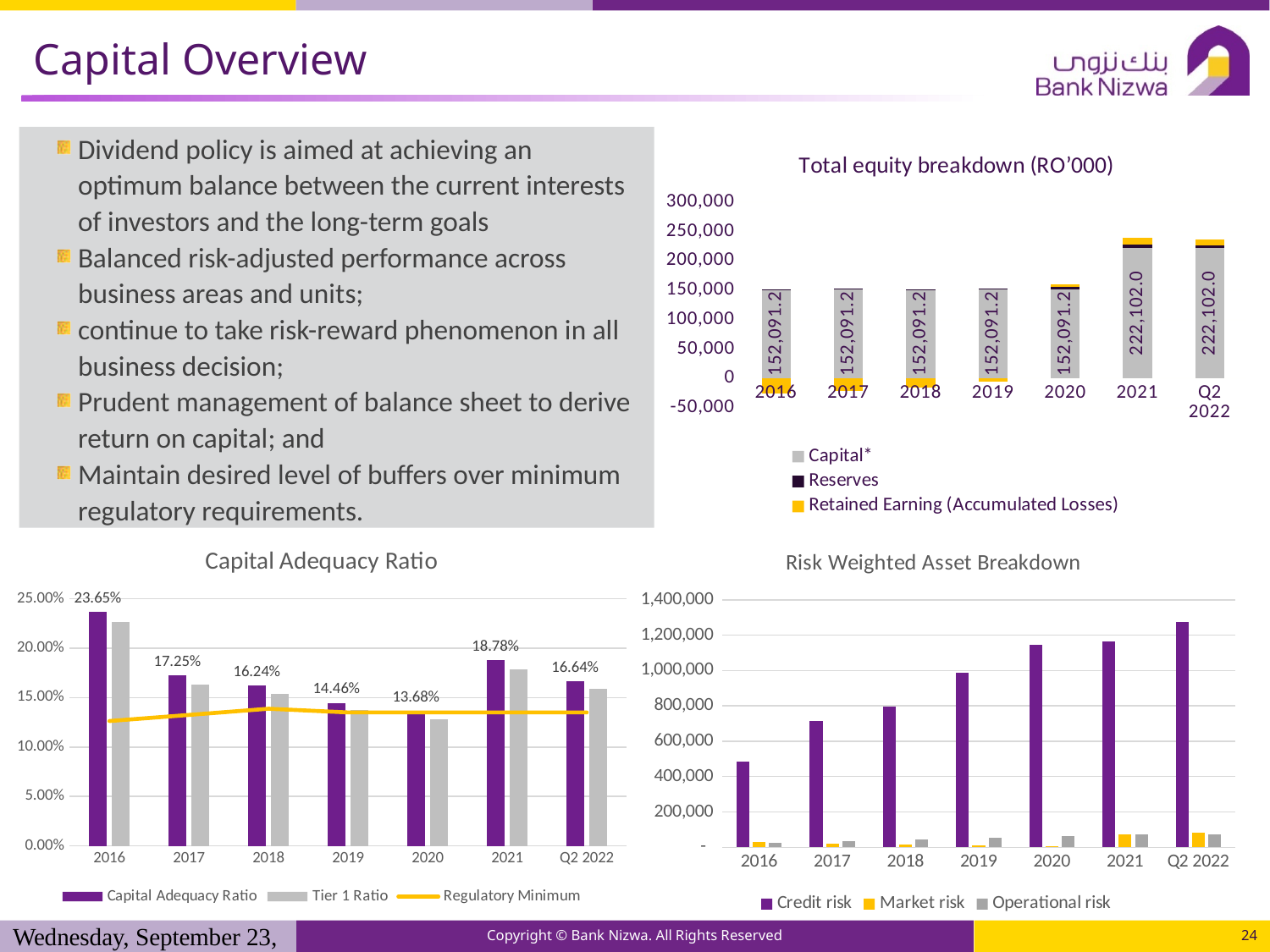
In the Total equity breakdown chart, how many periods are shown on the x axis? 7 In the Total equity breakdown chart, what is the Capital* value for 2018? 152,091.2 In the Risk Weighted Asset Breakdown chart, is the Credit risk value for 2016 greater or less than 600,000? less In the Risk Weighted Asset Breakdown chart, does Credit risk generally rise or fall from 2016 to Q2 2022? rise In the Total equity breakdown chart, what is the third legend entry? Retained Earning (Accumulated Losses) In the Capital Adequacy Ratio chart, what is the Capital Adequacy Ratio for 2016? 23.65% In the Capital Adequacy Ratio chart, what is the Capital Adequacy Ratio for Q2 2022? 16.64% In the Capital Adequacy Ratio chart, what is the difference between the Capital Adequacy Ratio in 2021 and in 2020? 5.10% In the Capital Adequacy Ratio chart, which year has the lowest labelled Capital Adequacy Ratio? 2020 In the Capital Adequacy Ratio chart, is the Capital Adequacy Ratio higher in 2017 or in 2018? 2017 In the Capital Adequacy Ratio chart, how many entries does the legend list? 3 In the Total equity breakdown chart, what is the Capital* value for 2021? 222,102.0